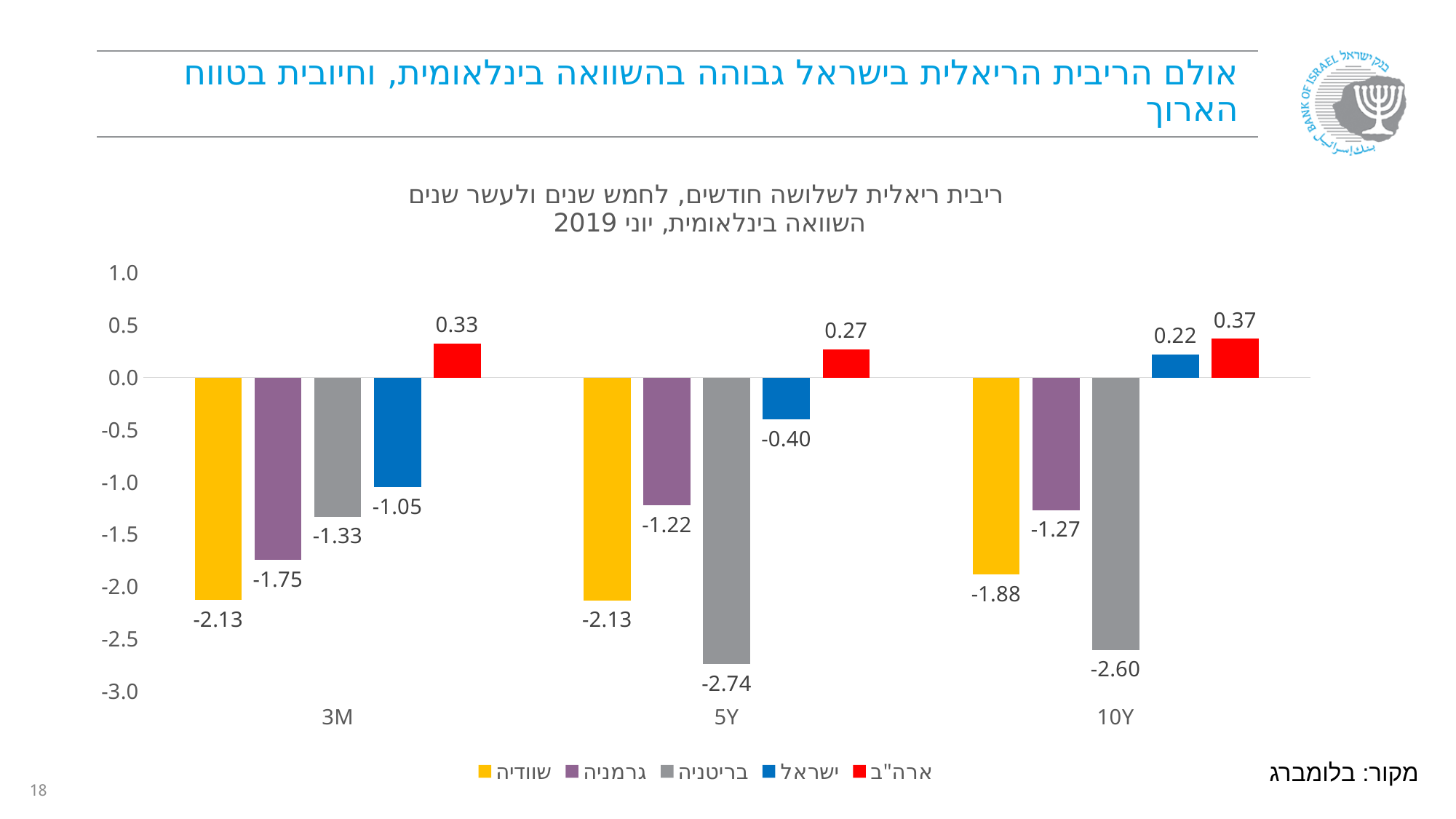
Which is larger at 5Y: the value for Germany (גרמניה) or the value for Sweden (שוודיה)? Germany (גרמניה) Which series has the lowest value at 5Y? Britain (בריטניה) Is the value for Sweden (שוודיה) at 10Y greater or less than -1.5? less What is the value for Israel (ישראל) at 3M? -1.05 What is the difference between the USA (ארה"ב) and Israel (ישראל) values at 10Y? 0.15 What is the value for the USA (ארה"ב) at 10Y? 0.37 Which colour represents Israel (ישראל) in the legend? blue How many categories are shown on the x axis? 3 Which series has the highest value at 3M? USA (ארה"ב) What is the value for Britain (בריטניה) at 5Y? -2.74 How many series does the legend list? 5 What kind of chart is shown on the slide? bar chart